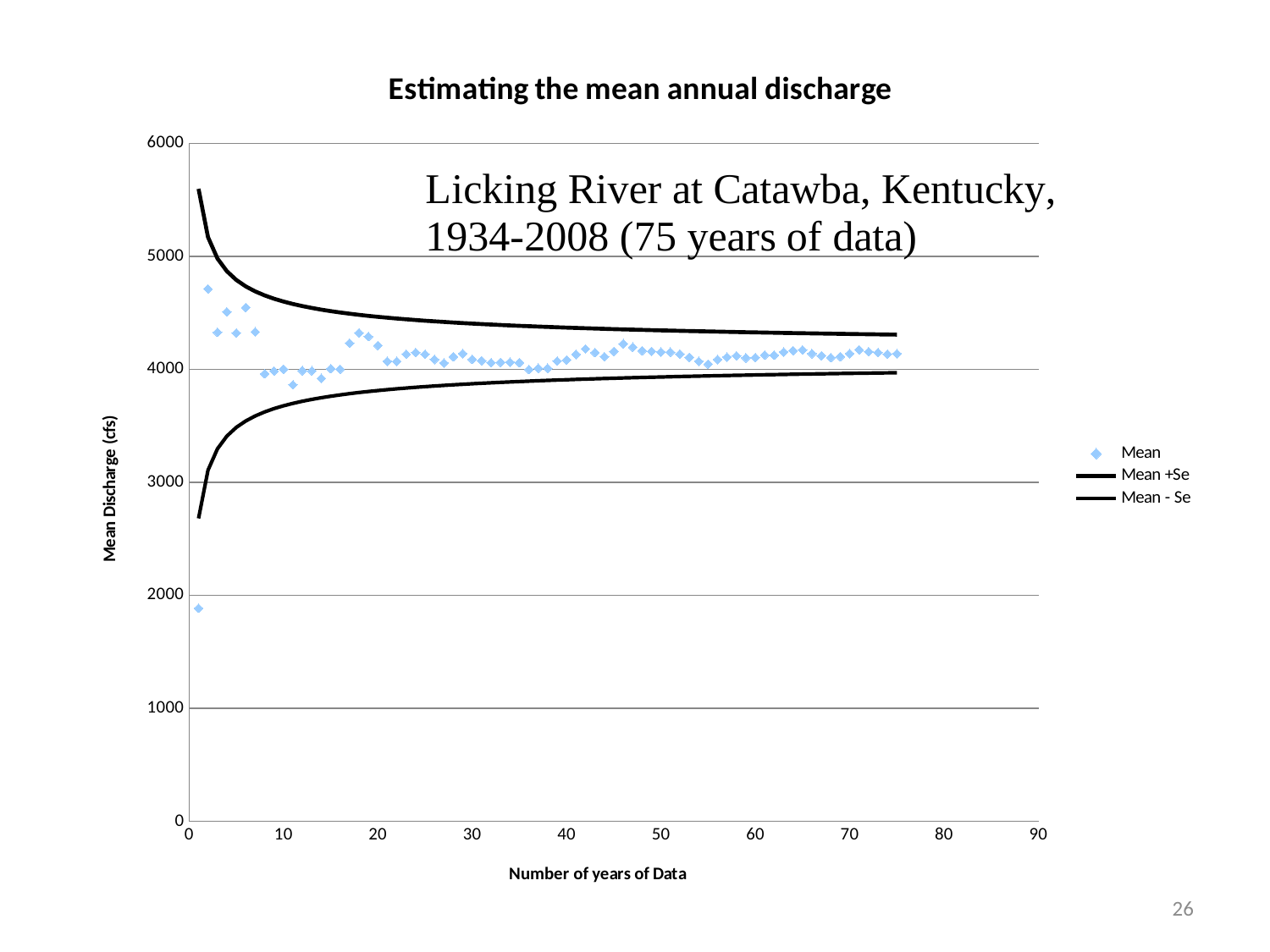
Is the Mean value at 75 years of data greater or less than 4000? greater What kind of chart is this? scatter chart At 1 year of data, which is larger: Mean +Se or Mean - Se? Mean +Se What is the label of the x axis? Number of years of Data Is the Mean +Se value at 1 year of data greater or less than 5000? greater How many series does the legend list? 3 Is the Mean value at 1 year of data greater or less than 2000? less What is the title of the chart? Estimating the mean annual discharge Does the Mean +Se line rise or fall as the number of years of data increases? fall At which number of years of data is the Mean series lowest? 1 Does the Mean - Se line rise or fall as the number of years of data increases? rise